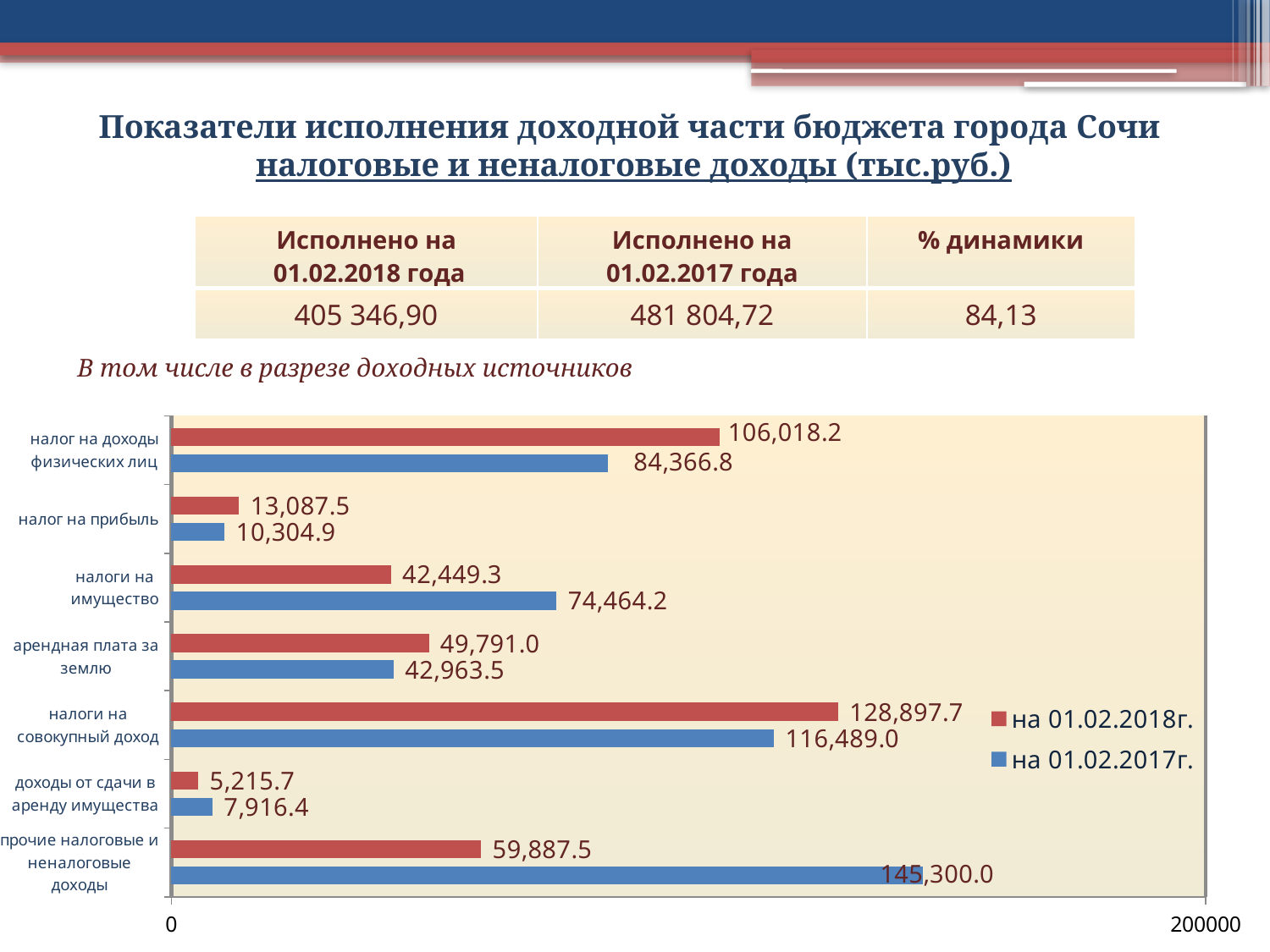
What is the value for налог на доходы физических лиц in the series на 01.02.2018г.? 106,018.2 What kind of chart is shown on the slide? bar chart Which category has the highest value in the series на 01.02.2018г.? налоги на совокупный доход What is the difference between the на 01.02.2017г. and на 01.02.2018г. values for прочие налоговые и неналоговые доходы? 85,412.5 What is the difference between the на 01.02.2018г. and на 01.02.2017г. values for налог на доходы физических лиц? 21,651.4 Which category has the lowest value in the series на 01.02.2018г.? доходы от сдачи в аренду имущества For налоги на имущество, which series has the larger value: на 01.02.2018г. or на 01.02.2017г.? на 01.02.2017г. What is the value for налоги на имущество in the series на 01.02.2017г.? 74,464.2 Which category has the highest value in the series на 01.02.2017г.? прочие налоговые и неналоговые доходы How many categories are shown on the chart? 7 How many series does the legend list? 2 What is the value for доходы от сдачи в аренду имущества in the series на 01.02.2018г.? 5,215.7